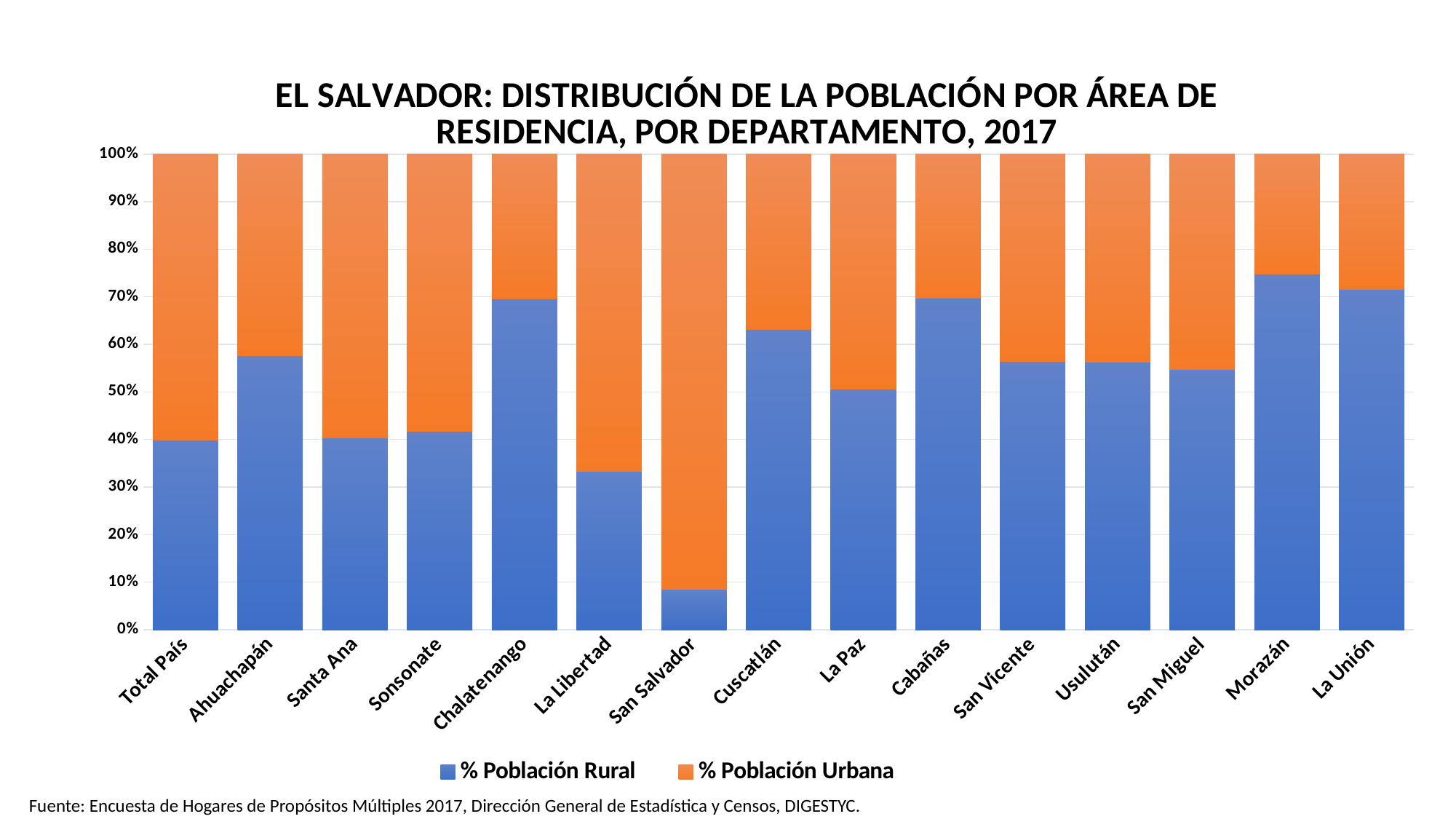
Which category has the largest % Población Urbana share? San Salvador What kind of chart is shown on the slide? Stacked bar chart Is the % Población Rural for San Salvador greater or less than 10%? less Which has a larger % Población Rural, Ahuachapán or Santa Ana? Ahuachapán How many departments/categories are shown along the x axis? 15 Which colour represents % Población Urbana in the chart? Orange Is the % Población Rural for Cuscatlán greater or less than 60%? greater Which category has the highest % Población Rural? Morazán Which category has the lowest % Población Rural? San Salvador Is the % Población Rural for La Libertad greater or less than 40%? less How many series does the legend list? 2